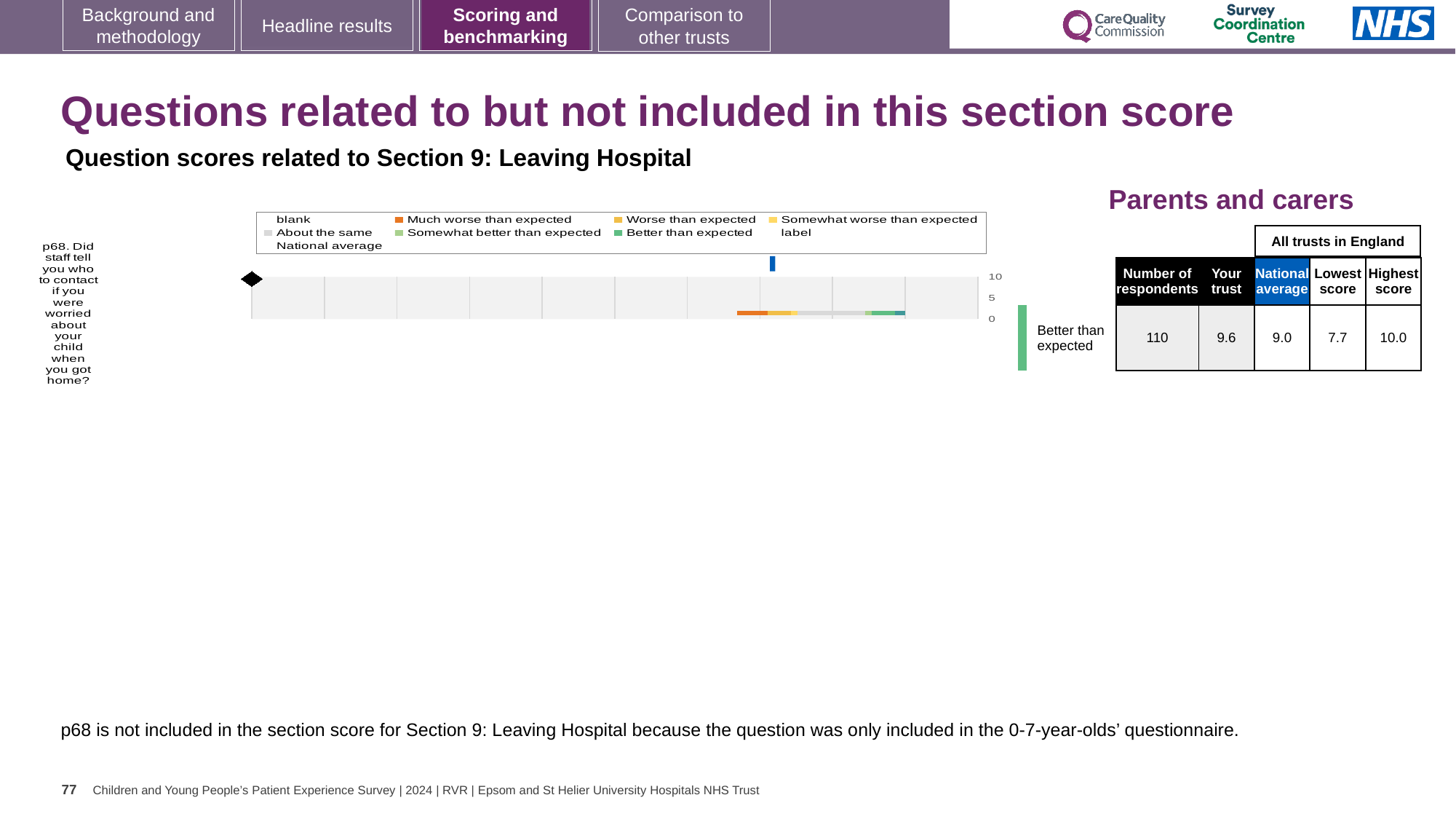
What is the lowest score across all trusts in England for p68? 7.7 How many entries does the chart legend list? 9 Which legend entry is shown in light grey? About the same What kind of chart is shown on the slide for question p68? bar chart Which is larger for p68: the 'Your trust' score or the national average? Your trust What is the highest score across all trusts in England for p68? 10.0 Which legend entry is shown in orange? Much worse than expected By how much does the 'Your trust' score for p68 exceed the national average? 0.6 What is the 'Your trust' score for p68 in the Parents and carers table? 9.6 What is the national average score for p68 in the Parents and carers table? 9.0 What is the number of respondents for p68 in the Parents and carers table? 110 How many questions are plotted on the chart? 1